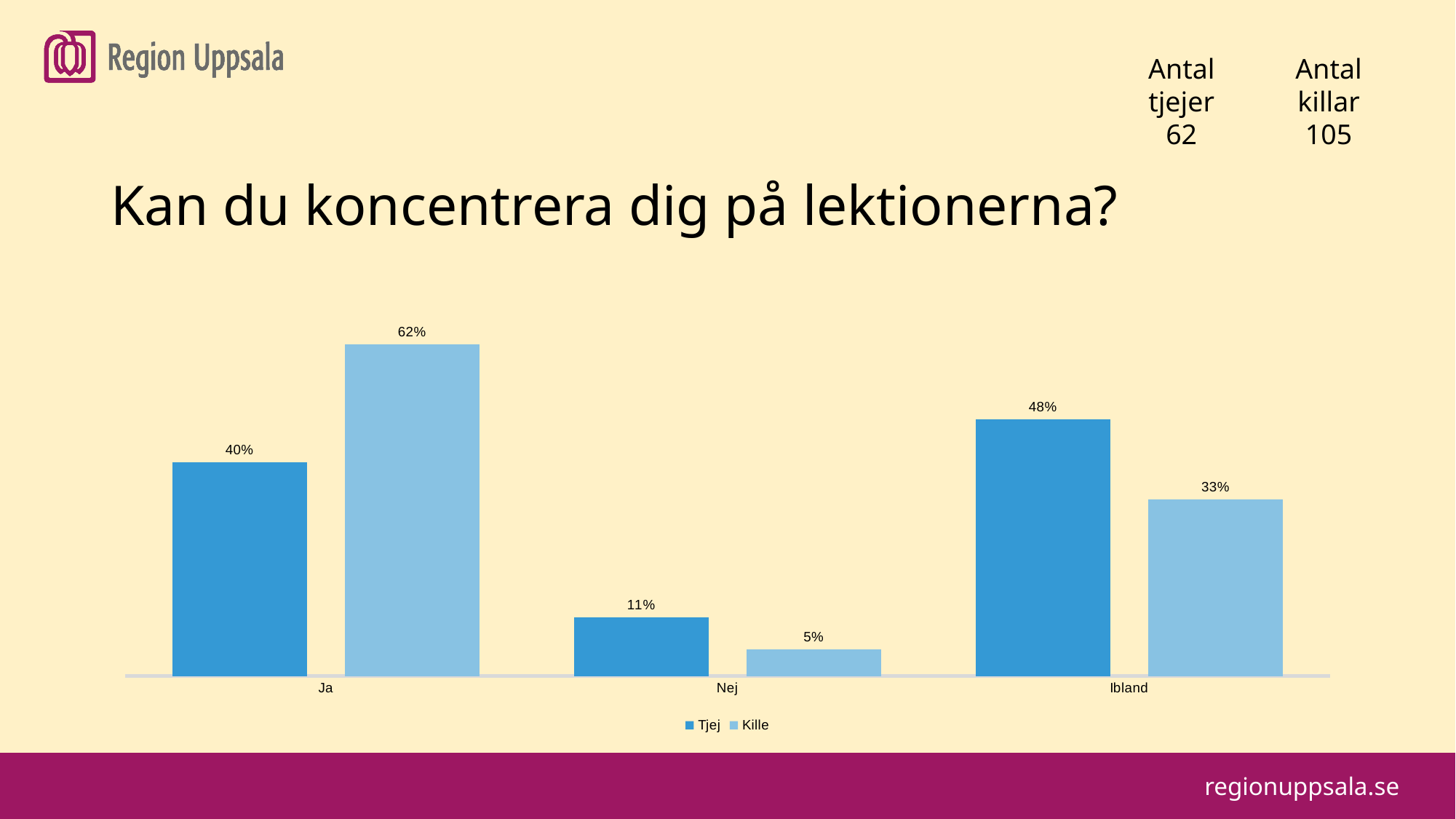
In the Nej category, which series has the larger value, Tjej or Kille? Tjej How many series does the legend list? 2 What percentage of Tjej answered Ja? 40% Which category has the lowest value for the Tjej series? Nej What kind of chart is shown on the slide? Bar chart What percentage of Kille answered Ja? 62% What is the value for Kille in the Nej category? 5% What is the difference between the Tjej and Kille values for Ibland? 15% How many categories are shown on the x axis? 3 What is the difference between the Kille and Tjej values for Ja? 22% What is the value for Tjej in the Ibland category? 48% Which category has the highest value for the Kille series? Ja